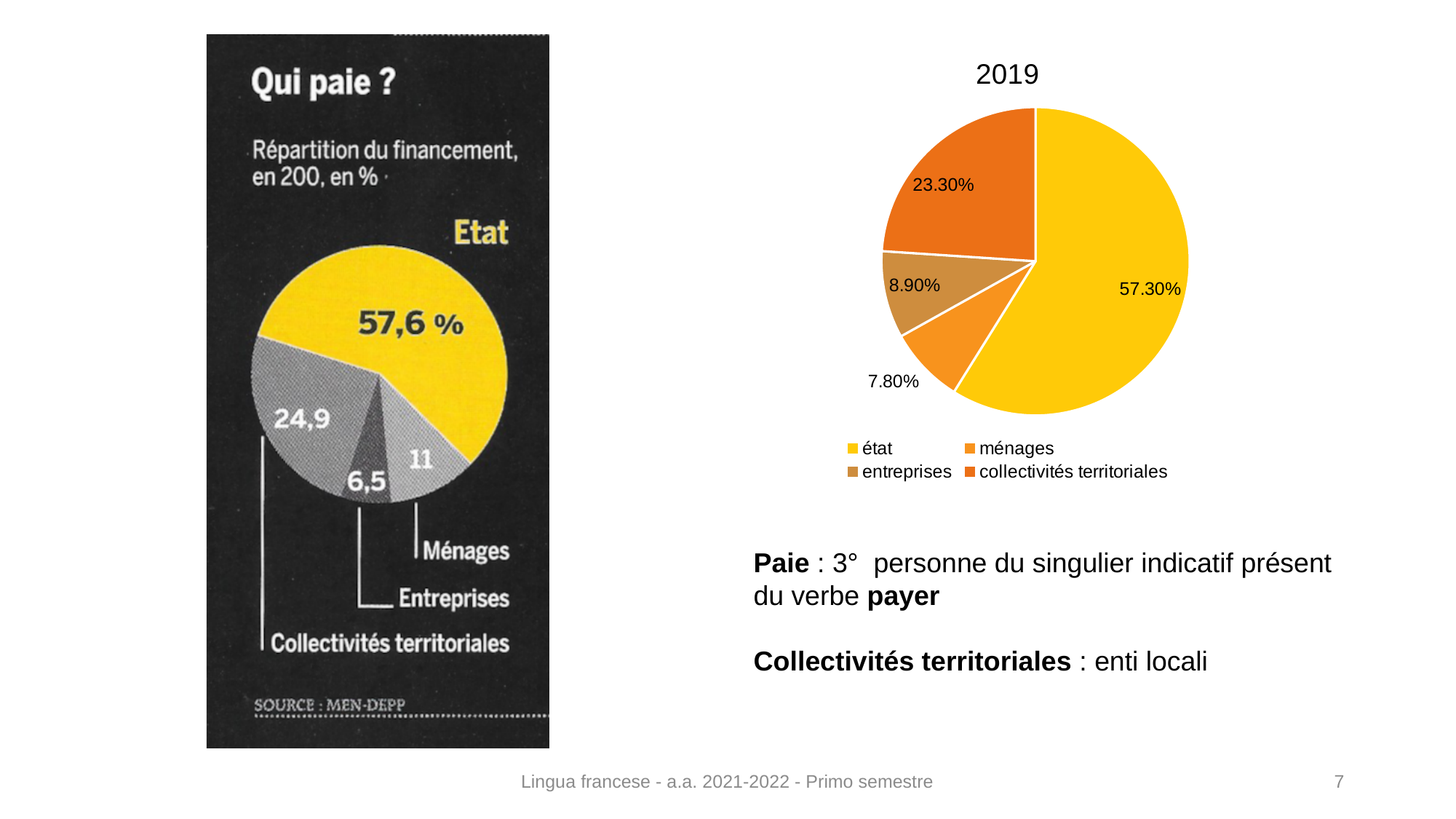
In the "2019" pie chart, how many categories does the legend list? 4 In the "Qui paie ?" chart on the left, what is the value for Collectivités territoriales? 24,9 In the "2019" pie chart, what is the value for collectivités territoriales? 23.30% In the "2019" pie chart, what is the value for entreprises? 8.90% In the "2019" pie chart, what is the difference between the values for état and collectivités territoriales? 34.00% In the "Qui paie ?" chart on the left, which is larger, Ménages or Entreprises? Ménages In the "2019" pie chart, what colour is the état slice? yellow In the "Qui paie ?" chart on the left, what is the value for Etat? 57,6 % In the "2019" pie chart, which category has the largest share? état In the "2019" pie chart, what is the value for état? 57.30% In the "2019" pie chart, what is the value for ménages? 7.80% What kind of chart is the "2019" chart on the right of the slide? pie chart